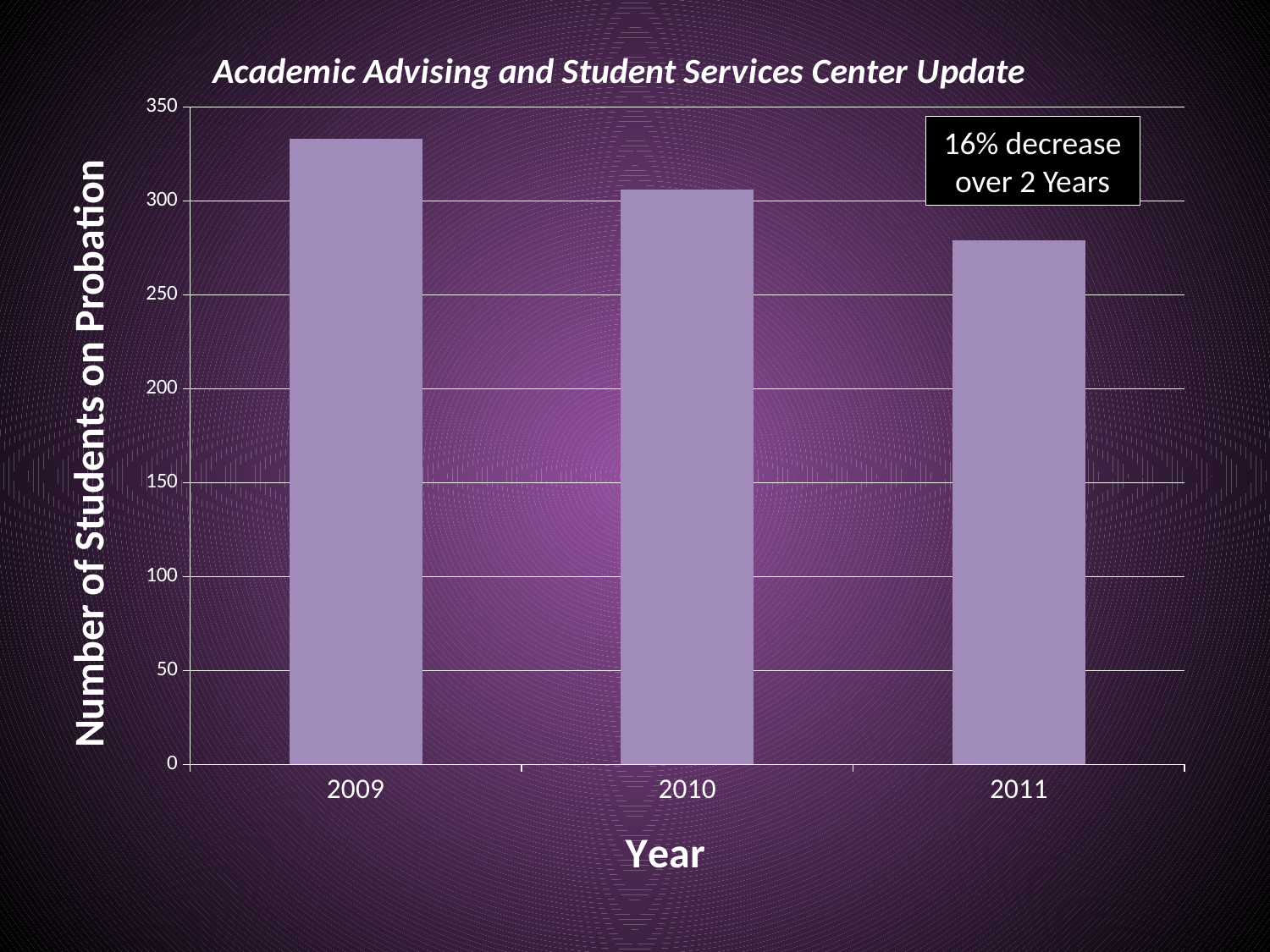
Do the values rise or fall from 2009 to 2011? fall How many years are plotted on the chart? 3 Is the value for 2009 greater or less than 300? greater Which year has the lowest number of students on probation? 2011 Which is larger, the value for 2009 or the value for 2011? 2009 What does the text box on the chart say? 16% decrease over 2 Years Is the value for 2011 greater or less than 300? less Which year has the highest number of students on probation? 2009 What is the label of the y axis? Number of Students on Probation Is the value for 2010 greater or less than 250? greater What is the title of the chart? Academic Advising and Student Services Center Update What kind of chart is shown on the slide? bar chart